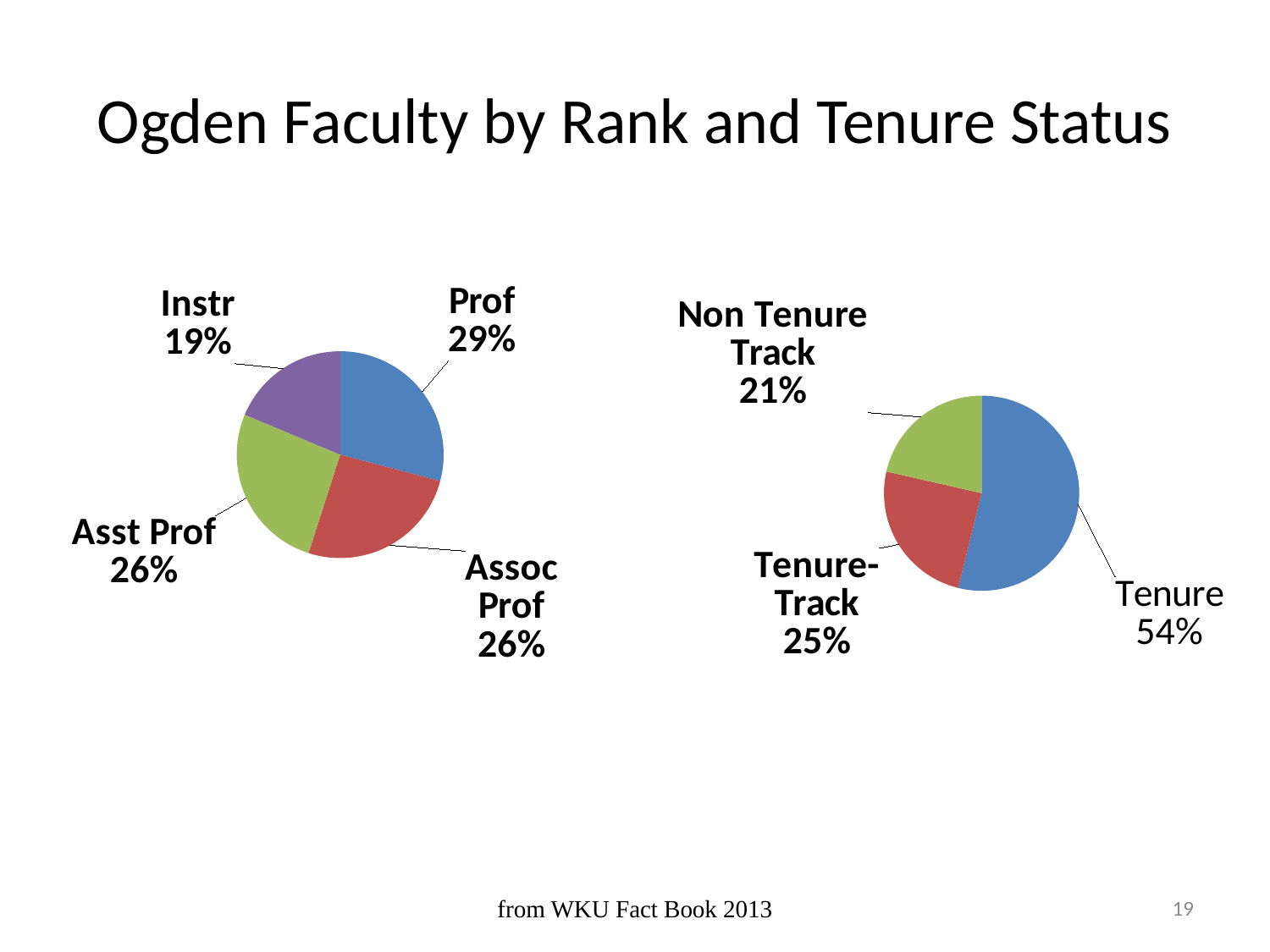
In the left pie chart (faculty by rank), what percentage of faculty are Prof? 29% In the right pie chart (tenure status), what percentage of faculty are Tenure-Track? 25% In the right pie chart (tenure status), how many categories are shown? 3 In the right pie chart (tenure status), which category has the largest share? Tenure In the left pie chart (faculty by rank), which rank has the smallest share? Instr In the left pie chart (faculty by rank), how many slices does the pie have? 4 In the left pie chart (faculty by rank), which rank has the largest share? Prof What type of chart is used on this slide? Pie chart In the left pie chart (faculty by rank), what is the difference in percentage points between Prof and Instr? 10 In the right pie chart (tenure status), which is larger, Tenure-Track or Non Tenure Track? Tenure-Track In the left pie chart (faculty by rank), what percentage of faculty are Instr? 19% In the right pie chart (tenure status), what percentage of faculty are Non Tenure Track? 21%